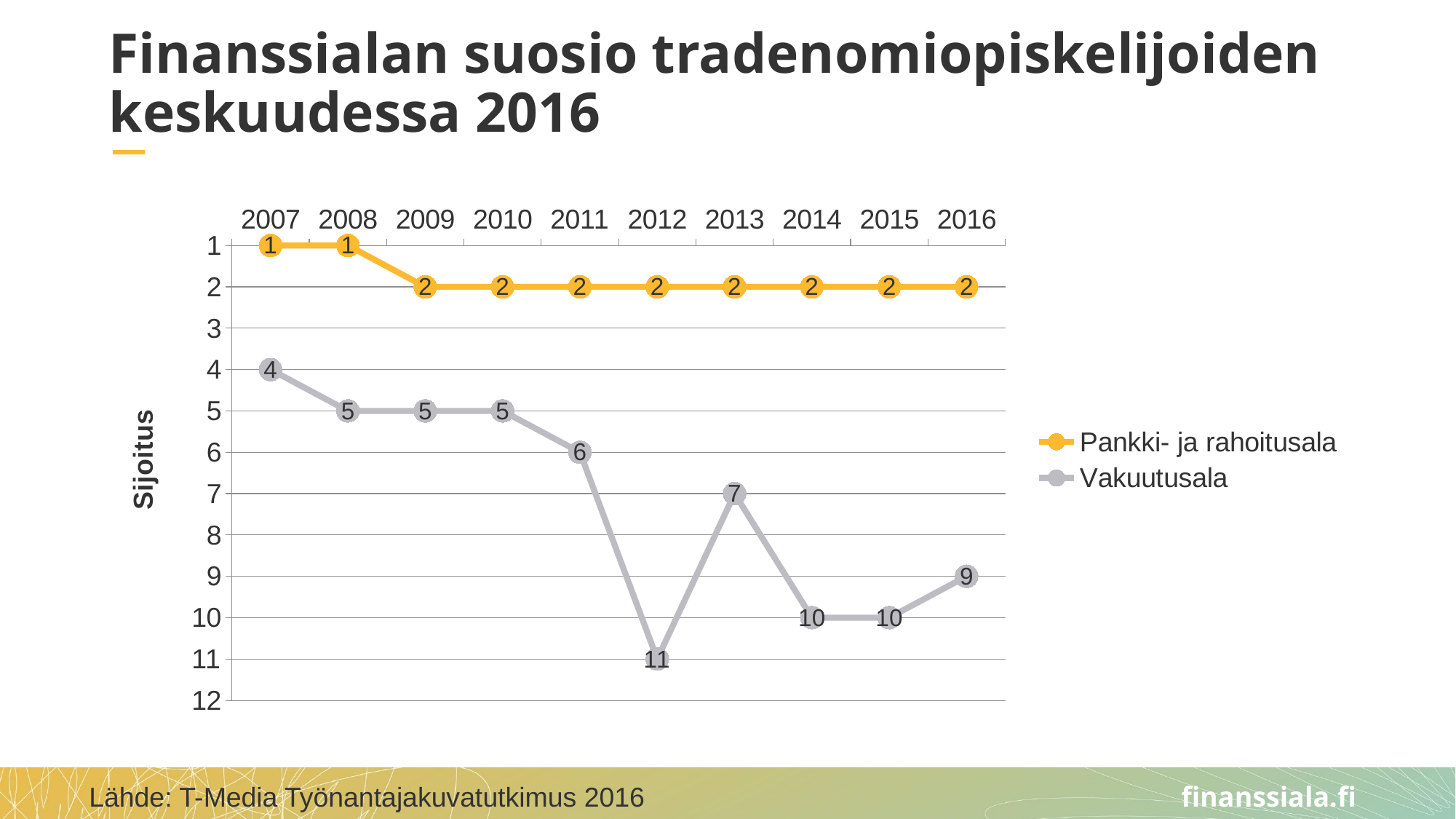
In which year does Vakuutusala have its largest ranking number (worst position)? 2012 What is the Vakuutusala ranking in 2016? 9 What is the label of the y axis? Sijoitus Which series has the larger ranking number in 2014, Pankki- ja rahoitusala or Vakuutusala? Vakuutusala How many series does the legend list? 2 How many years are plotted along the x axis? 10 What is the difference between the Vakuutusala ranking in 2012 and in 2013? 4 What is the Pankki- ja rahoitusala ranking in 2007? 1 What is the Pankki- ja rahoitusala ranking in 2016? 2 What is the Vakuutusala ranking (Sijoitus) in 2012? 11 In which year does Vakuutusala have its smallest ranking number (best position)? 2007 What type of chart is shown on the slide? line chart